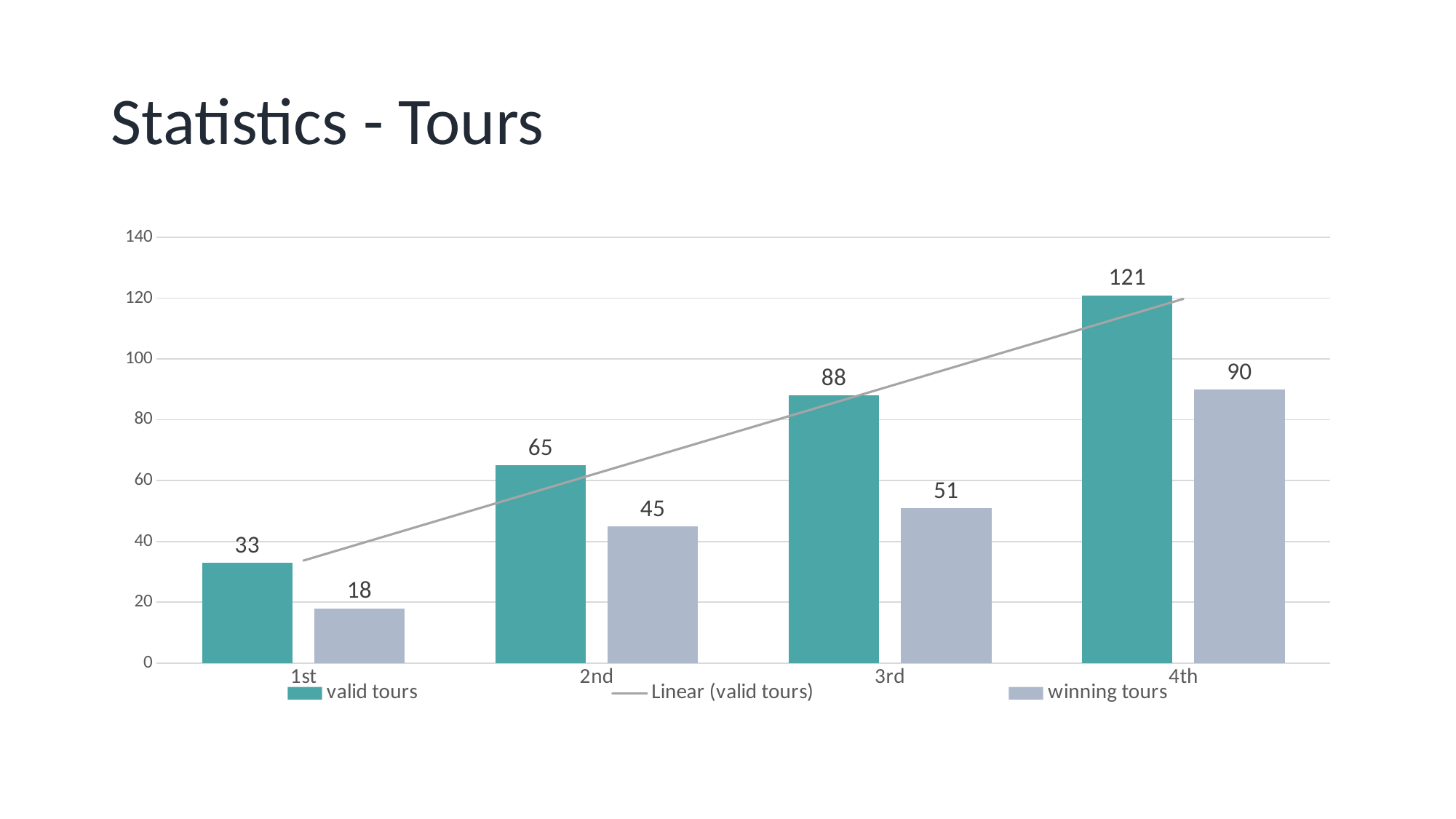
Which is larger: winning tours in the 3rd category or valid tours in the 1st category? winning tours in the 3rd category What is the value of winning tours for the 1st category? 18 How many categories are shown on the x axis? 4 How many entries does the legend list? 3 Do the valid tours values rise or fall from 1st to 4th? rise What is the value of winning tours for the 4th category? 90 What kind of chart is shown on the slide? bar chart What is the value of valid tours for the 3rd category? 88 Which category has the highest number of valid tours? 4th What is the difference in valid tours between the 4th and 1st categories? 88 Which category has the lowest number of winning tours? 1st What is the difference between valid tours and winning tours in the 2nd category? 20